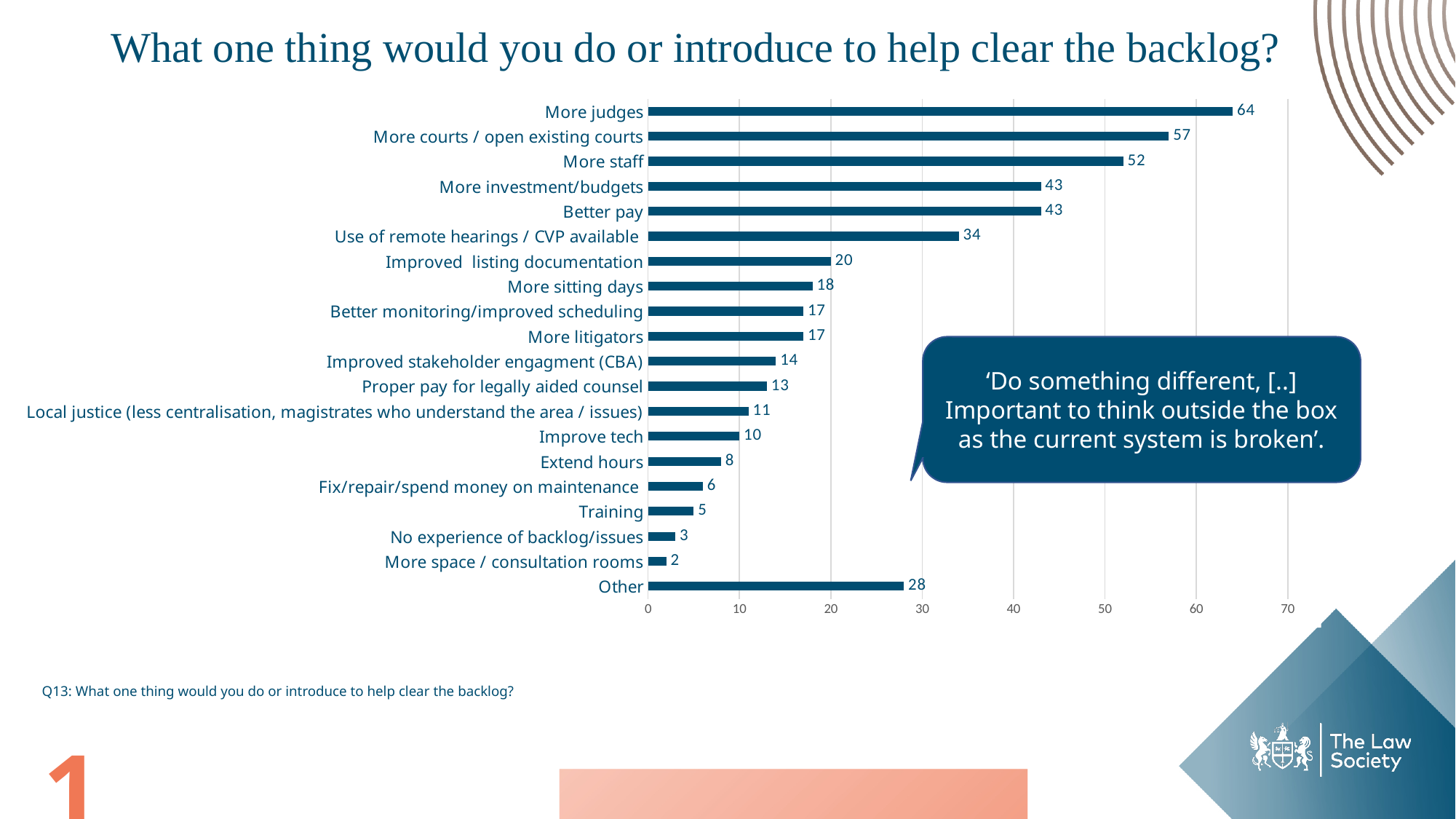
What kind of chart is shown on the slide? Bar chart Which category has the lowest value? More space / consultation rooms What is the title of the slide? What one thing would you do or introduce to help clear the backlog? What is the value for Other? 28 What is the value for More judges? 64 What is the value for Training? 5 Which is larger, More staff or More investment/budgets? More staff How many categories are shown in the chart? 20 What is the difference between More judges and More courts / open existing courts? 7 Which category has the highest value? More judges What is the value for Use of remote hearings / CVP available? 34 Is the value for Better pay greater or less than 40? greater